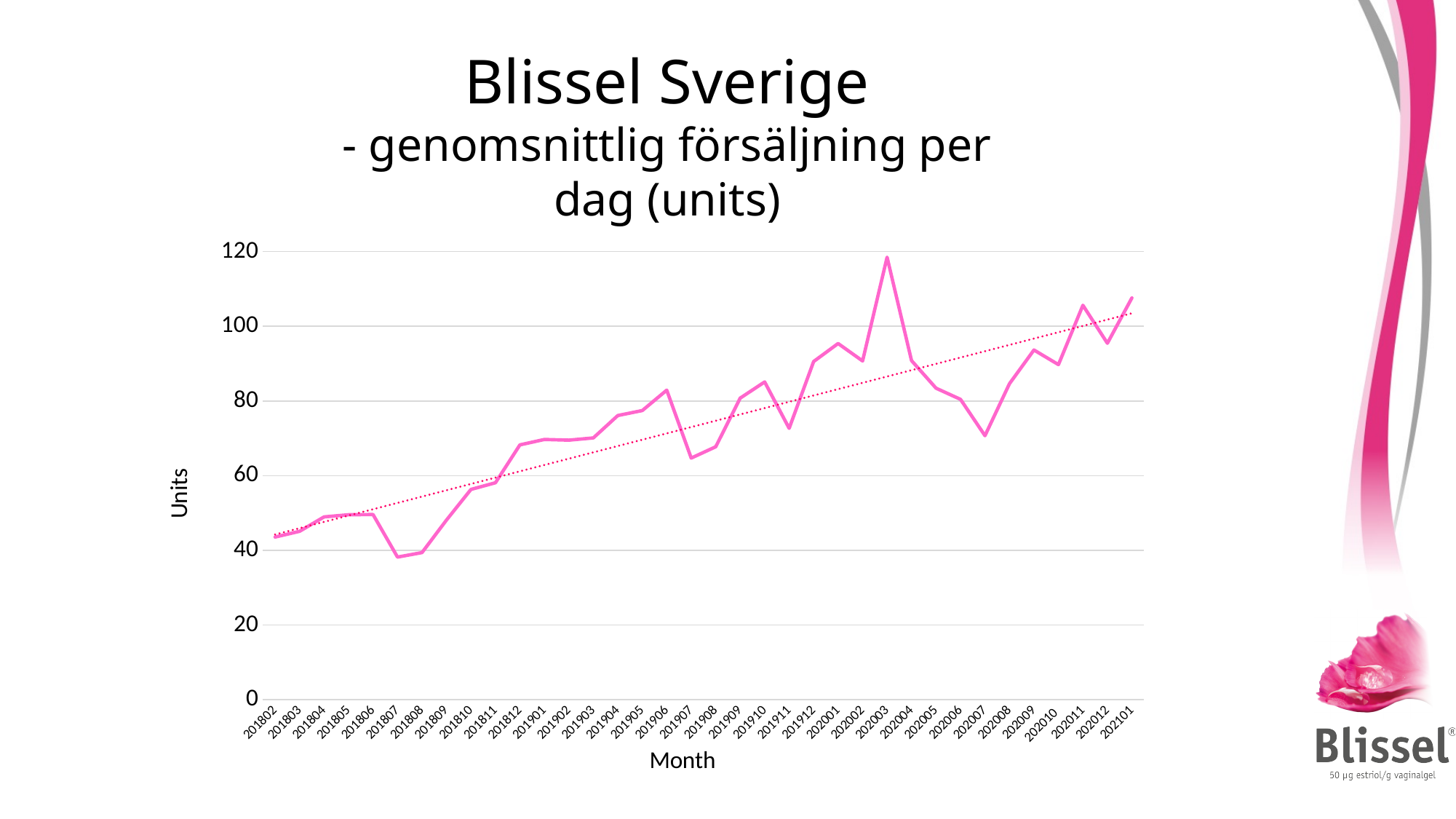
Do the values generally rise or fall from 201802 to 202101? rise Which is larger, the value for 202003 or the value for 202007? 202003 Which month has the highest value? 202003 What is the label of the vertical axis? Units Which month has the lowest value? 201807 Is the value for 202003 greater or less than 100? greater Is the value for 201807 greater or less than 40? less What kind of chart is shown on the slide? line chart What is the label of the horizontal axis? Month How many months are plotted on the x axis? 36 Is the value for 201907 greater or less than 80? less